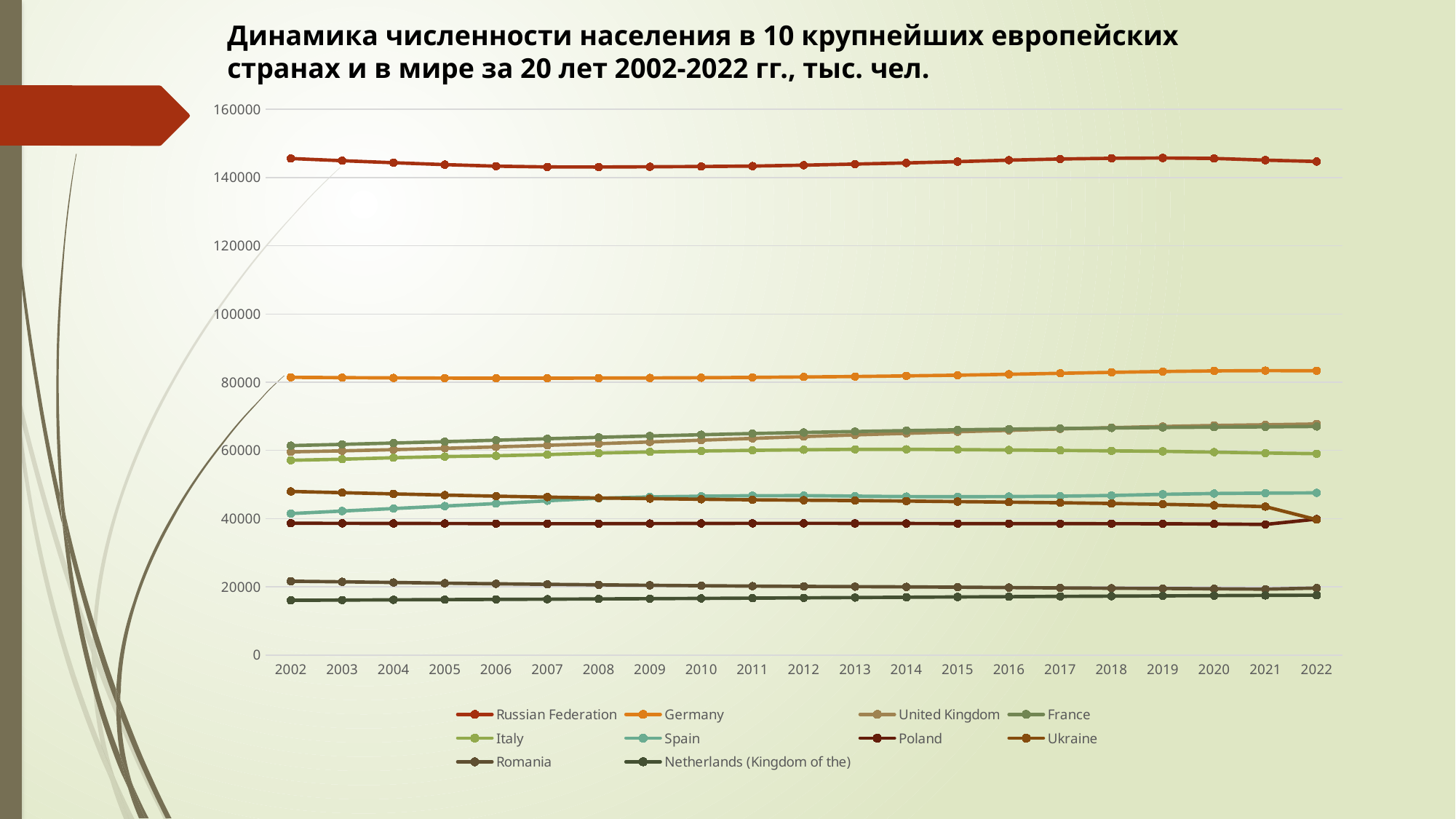
Does the population of Ukraine rise or fall from 2002 to 2022? fall What kind of chart is shown on the slide? line chart Which country has the lowest population throughout the period? Netherlands (Kingdom of the) Which country has the highest population throughout the period? Russian Federation Is the value for Italy in 2002 greater or less than 60000? less In 2022, which is larger: the value for Germany or the value for Italy? Germany Is the value for the Netherlands (Kingdom of the) in 2022 greater or less than 20000? less Does the population of Germany rise or fall from 2002 to 2022? rise How many series does the legend list? 10 Is the value for the Russian Federation in 2022 greater or less than 140000? greater How many years are plotted along the x axis? 21